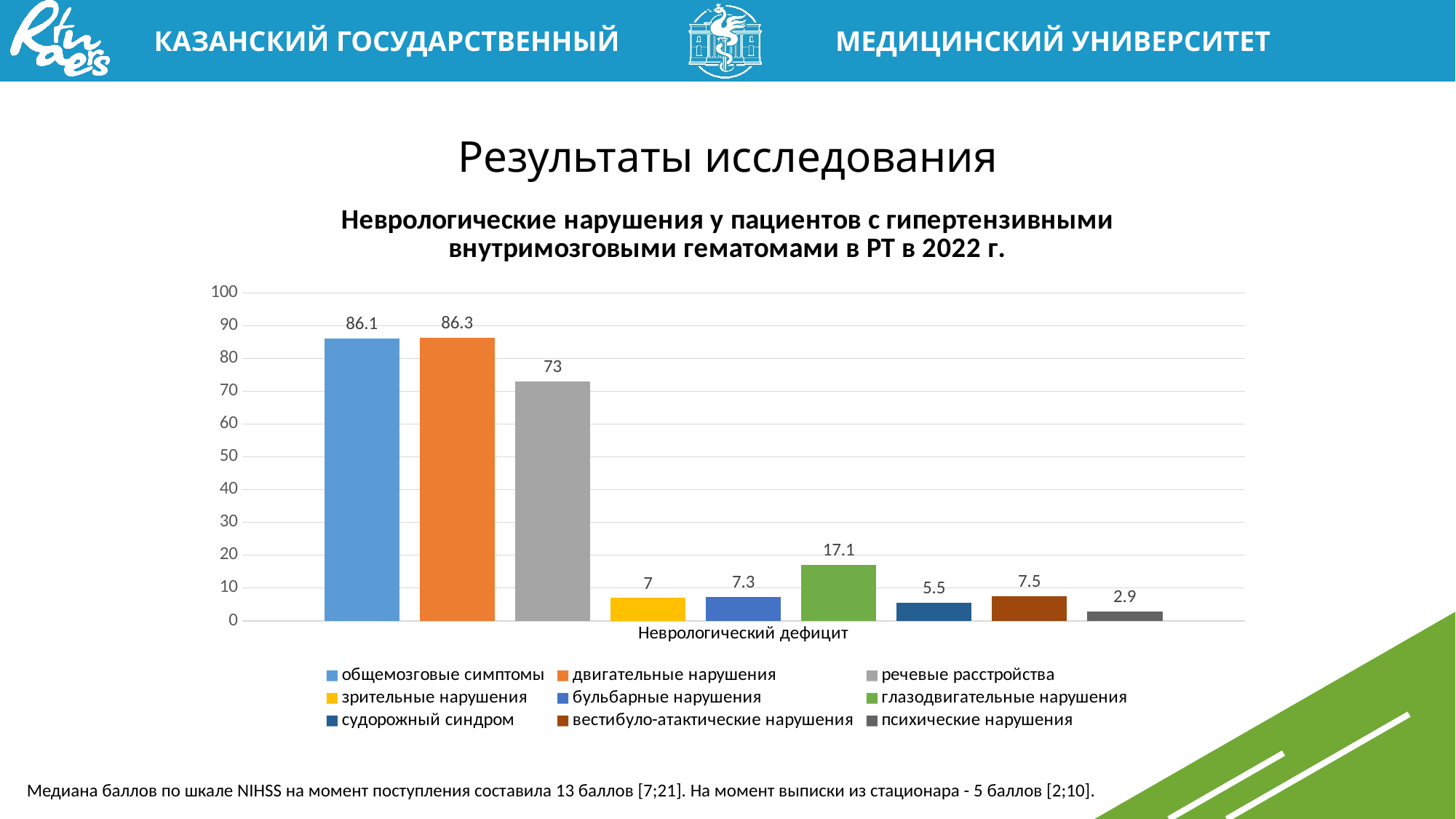
How many series does the legend list? 9 What colour is the bar for зрительные нарушения? Yellow What is the value for речевые расстройства? 73 What is the value for судорожный синдром? 5.5 Which series has the highest value? двигательные нарушения What is the value for общемозговые симптомы? 86.1 What is the value for глазодвигательные нарушения? 17.1 Which series has the lowest value? психические нарушения What kind of chart is shown on the slide? Bar chart What is the label on the x axis under the bars? Неврологический дефицит Which is larger, the value for бульбарные нарушения or the value for вестибуло-атактические нарушения? вестибуло-атактические нарушения What is the difference between the values for двигательные нарушения and речевые расстройства? 13.3